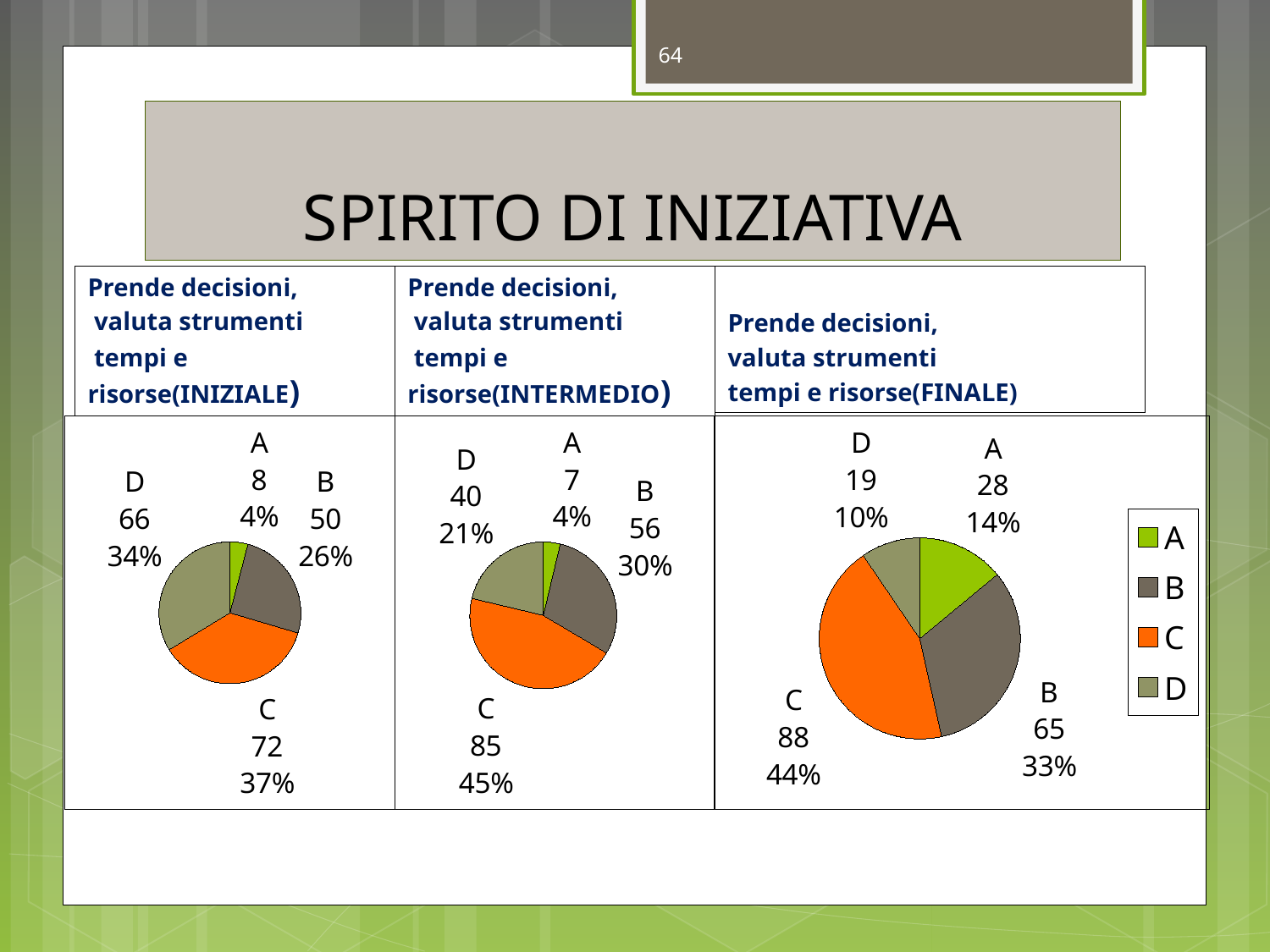
In the legend next to the FINALE pie chart, which colour represents category C? Orange How many categories does each pie chart on the slide have? 4 In the INIZIALE pie chart, what is the value for category C? 72 In the FINALE pie chart, what is the value for category A? 28 In the INTERMEDIO pie chart, what is the value for category B? 56 In the INTERMEDIO pie chart, what share of the pie does category D represent? 21% In the FINALE pie chart, which category has the smallest slice? D In the INIZIALE pie chart, what share of the pie does category D represent? 34% In the INTERMEDIO pie chart, which category has the largest slice? C What type of chart is used on this slide for the INIZIALE, INTERMEDIO and FINALE data? Pie chart Which is larger: the value for D in the INIZIALE pie chart or the value for D in the FINALE pie chart? INIZIALE (66) In the FINALE pie chart, what is the difference between the values for C and B? 23